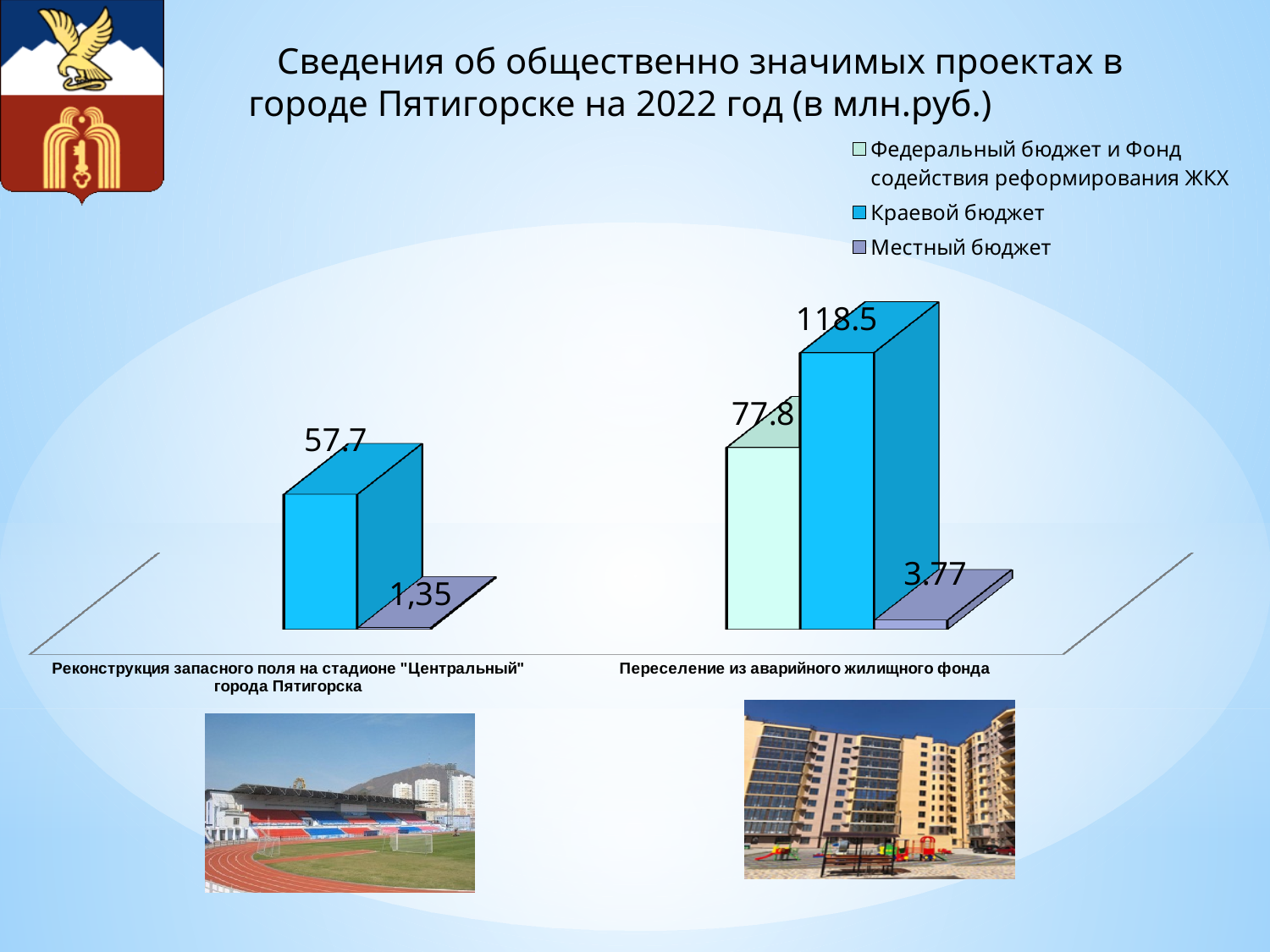
What is the difference between the Краевой бюджет values for the two projects? 60.8 Which bar on the chart has the highest value? Краевой бюджет for Переселение из аварийного жилищного фонда (118.5) Which bar on the chart has the lowest value? Местный бюджет for Реконструкция запасного поля на стадионе "Центральный" (1,35) What is the value of the Местный бюджет bar for "Переселение из аварийного жилищного фонда"? 3.77 Which project has the larger Краевой бюджет value? Переселение из аварийного жилищного фонда What is the value of the Местный бюджет bar for "Реконструкция запасного поля на стадионе "Центральный" города Пятигорска"? 1,35 How many project categories are shown on the chart? 2 What is the value of the Краевой бюджет bar for "Переселение из аварийного жилищного фонда"? 118.5 What is the value of the Федеральный бюджет и Фонд содействия реформирования ЖКХ bar for "Переселение из аварийного жилищного фонда"? 77.8 What is the value of the Краевой бюджет bar for "Реконструкция запасного поля на стадионе "Центральный" города Пятигорска"? 57.7 What kind of chart is shown on the slide? Bar chart How many series does the legend list? 3